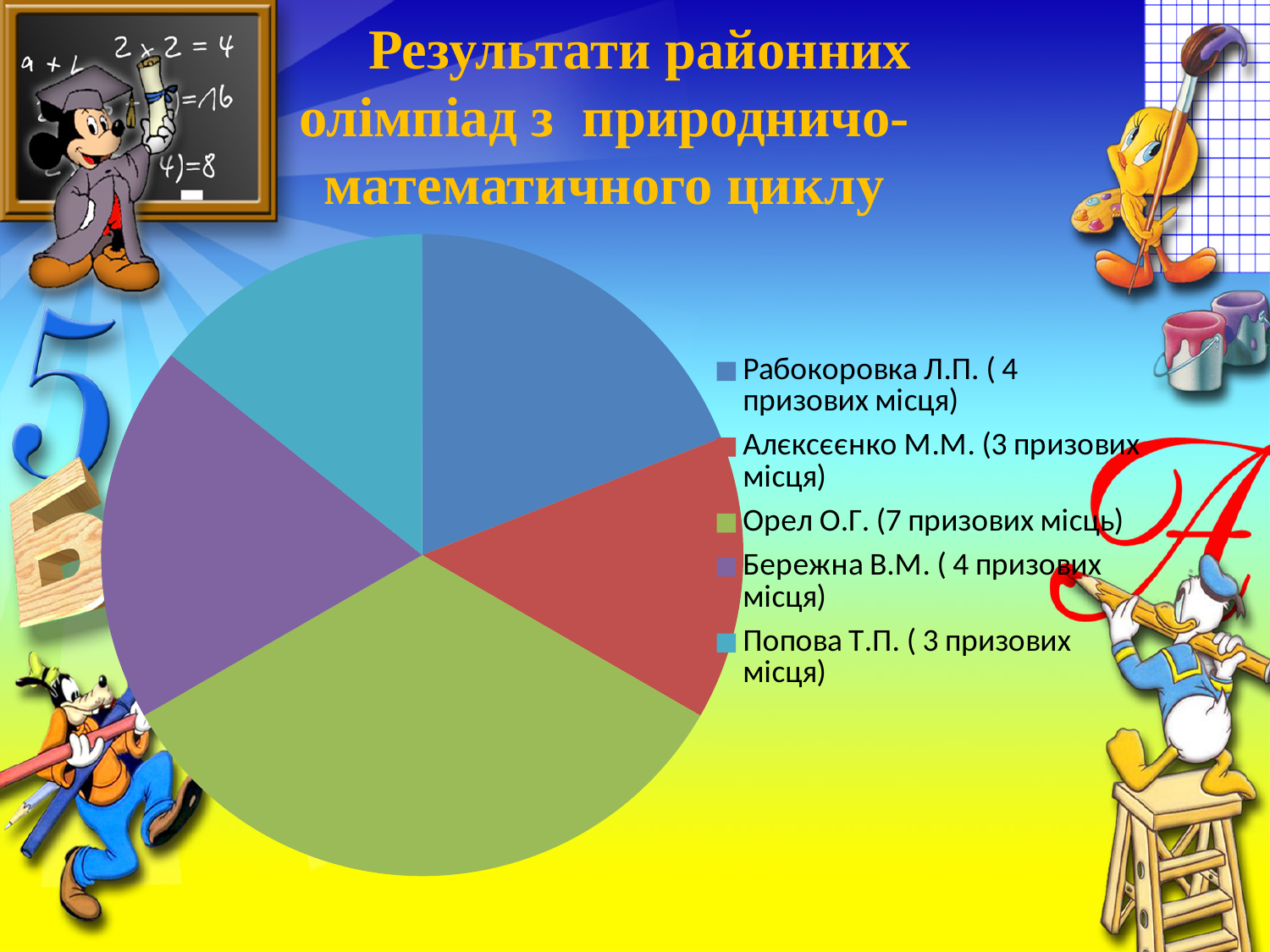
What is the difference in prize places between Бережна В.М. and Попова Т.П.? 1 What kind of chart is shown on the slide? pie chart Who has more prize places, Орел О.Г. or Бережна В.М.? Орел О.Г. What is the total number of prize places across all five teachers in the legend? 21 How many prize places does the legend give for Рабокоровка Л.П.? 4 What is the difference in prize places between Орел О.Г. and Рабокоровка Л.П.? 3 Who has more prize places, Рабокоровка Л.П. or Алєксєєнко М.М.? Рабокоровка Л.П. How many prize places does the legend give for Орел О.Г.? 7 How many prize places does the legend give for Попова Т.П.? 3 How many slices does the pie chart have? 5 What colour is the slice for Орел О.Г. in the pie chart? green Which teacher has the largest slice of the pie chart? Орел О.Г.